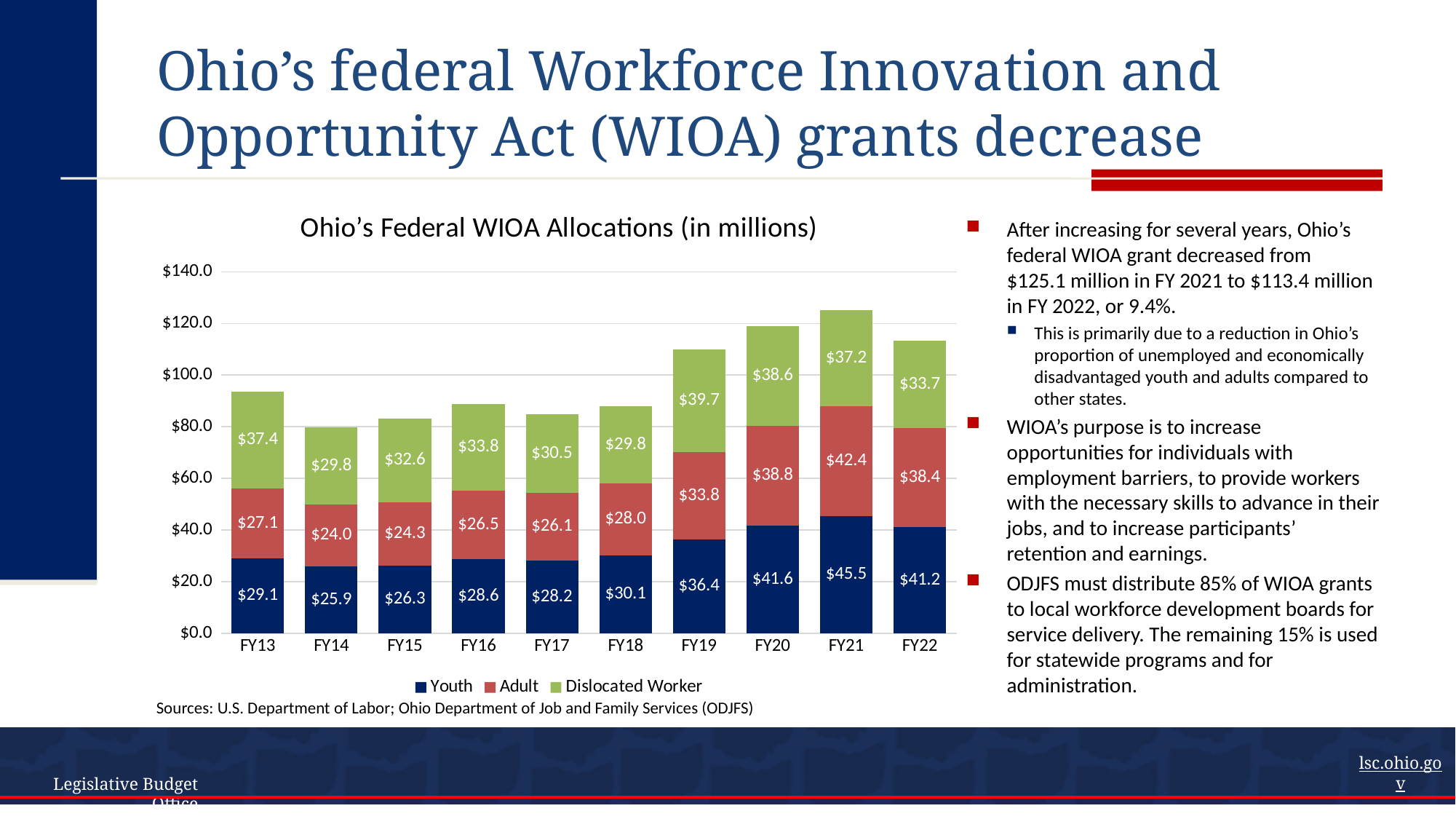
What is the total WIOA allocation for FY21 (sum of Youth, Adult and Dislocated Worker)? $125.1 In which fiscal year is the Youth allocation highest? FY21 How many series does the chart's legend list? 3 Which year has the larger Dislocated Worker allocation, FY19 or FY20? FY19 In which fiscal year is the Adult allocation lowest? FY14 By how much did the Youth allocation decrease from FY21 to FY22? $4.3 What is the Youth allocation for FY19 in the chart? $36.4 What is the Dislocated Worker allocation for FY13? $37.4 How many fiscal years are shown on the x axis of the chart? 10 What is the Adult allocation for FY21? $42.4 What kind of chart is used to show Ohio's Federal WIOA Allocations? Stacked bar chart Is the total allocation for FY21 greater or less than $120.0? greater